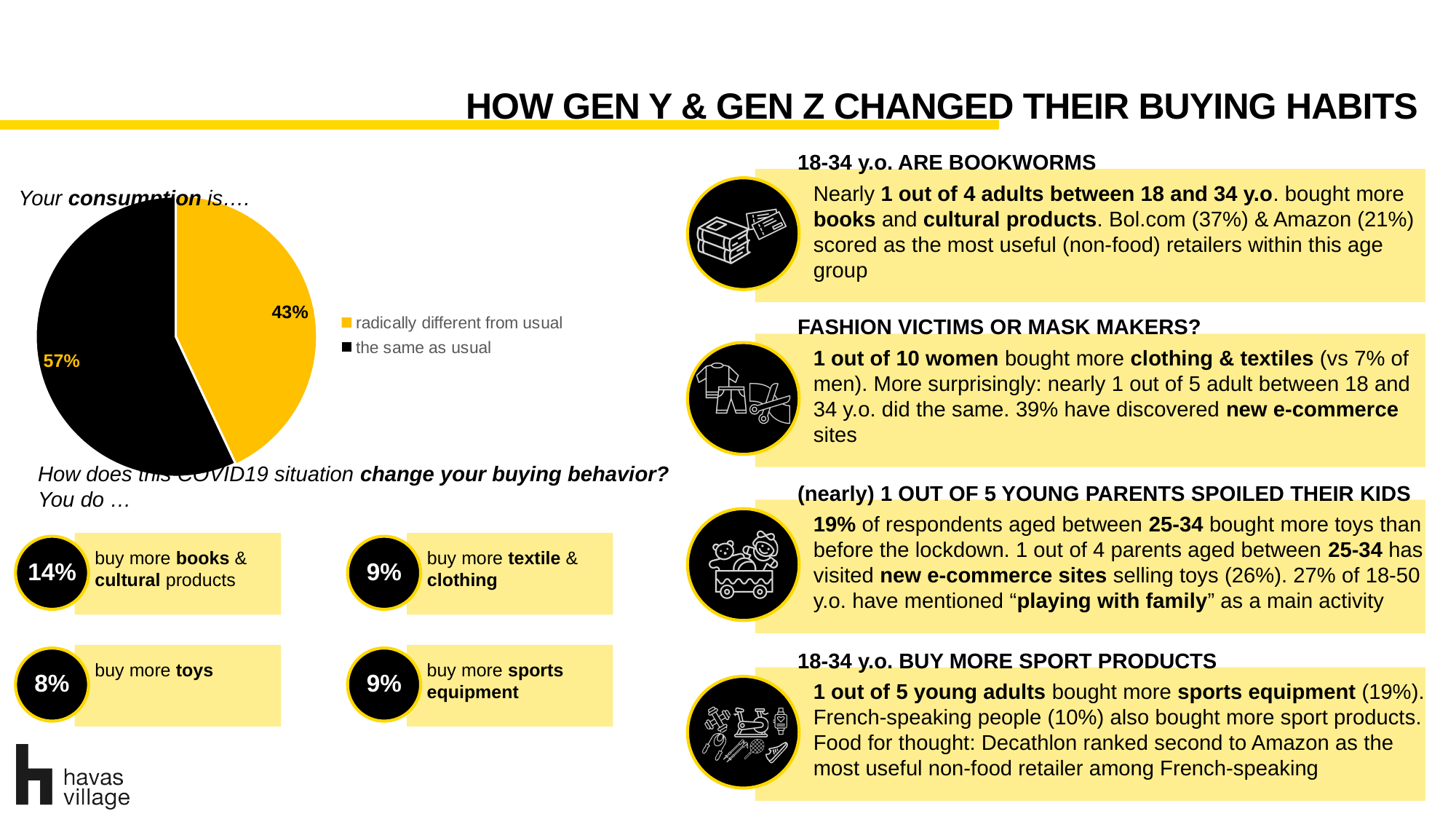
Which slice of the pie chart is the largest? the same as usual What is the difference in percentage points between 'the same as usual' and 'radically different from usual' in the pie chart? 14 percentage points In the pie chart, which is larger: 'radically different from usual' or 'the same as usual'? the same as usual In the pie chart, what percentage of respondents said their consumption is the same as usual? 57% In the pie chart, what percentage of respondents said their consumption is radically different from usual? 43% What is the title shown above the pie chart? Your consumption is…. Which slice of the pie chart is the smallest? radically different from usual What colour is the 'radically different from usual' slice in the pie chart? yellow How many entries does the pie chart's legend list? 2 What share of the pie does the 'the same as usual' slice represent? 57% What type of chart is used to show 'Your consumption is....'? pie chart How many slices does the pie chart have? 2